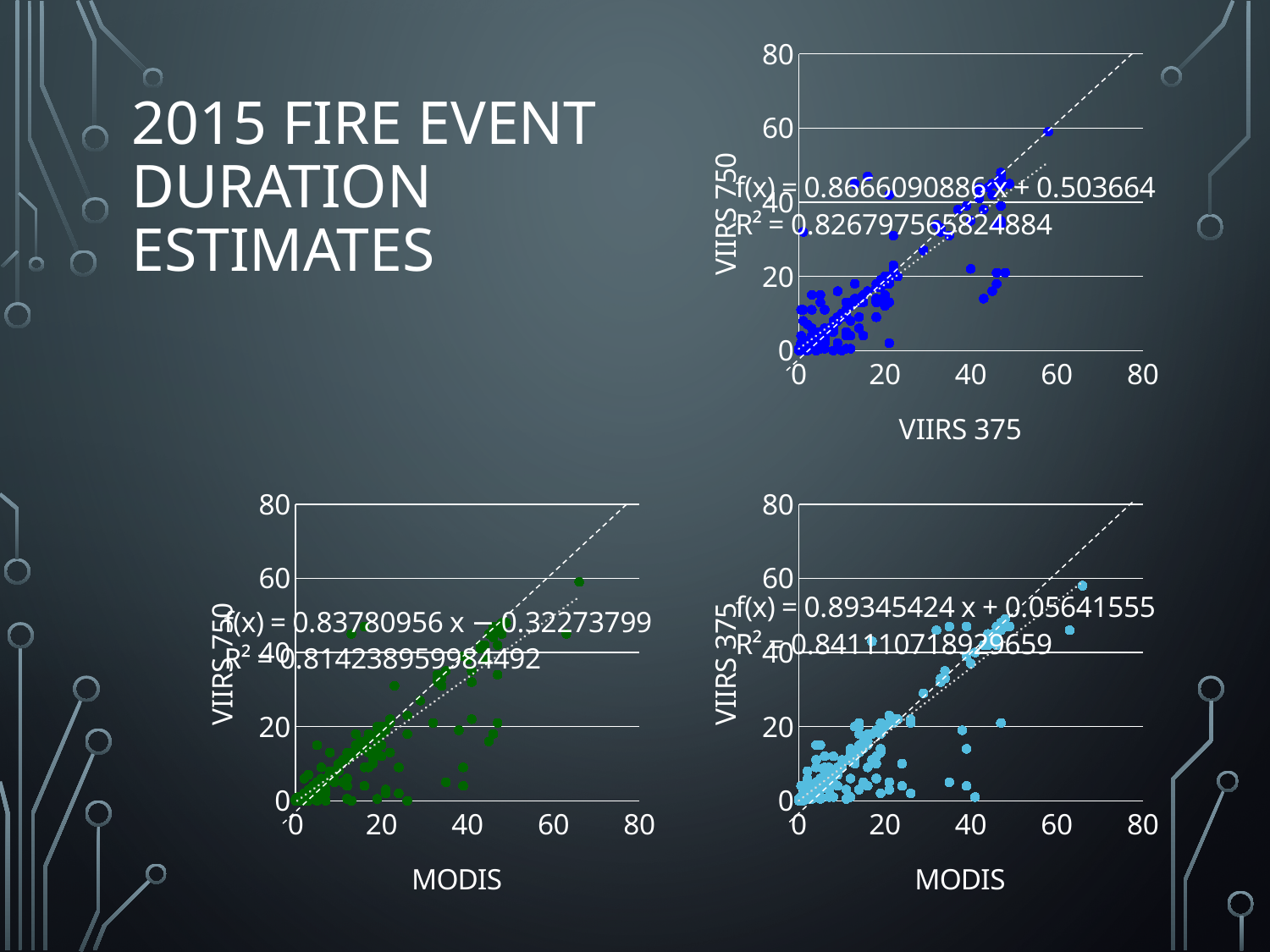
In the bottom-left chart (VIIRS 750 vs MODIS), what is the trendline equation printed on the chart? f(x) = 0.83780956 x − 0.32273799 Which chart has the highest R² value: the top-right, bottom-left, or bottom-right chart? Bottom-right In the bottom-right chart (VIIRS 375 vs MODIS), what is the trendline equation printed on the chart? f(x) = 0.89345424 x + 0.05641555 In the bottom-right chart, what is the label of the y axis? VIIRS 375 What kind of chart is the top-right chart with the x axis labelled VIIRS 375? Scatter chart In the bottom-left chart (VIIRS 750 vs MODIS), do the plotted points generally rise or fall as the x-axis value increases? Rise In the top-right chart, what is the label of the x axis? VIIRS 375 In the top-right chart (VIIRS 750 vs VIIRS 375), what is the R² value printed on the chart? 0.826797565824884 In the bottom-left chart (VIIRS 750 vs MODIS), what is the R² value printed on the chart? 0.814238959984492 How many charts are shown on the slide? 3 In the bottom-right chart (VIIRS 375 vs MODIS), what is the R² value printed on the chart? 0.841110718929659 Which chart has the lowest R² value: the top-right, bottom-left, or bottom-right chart? Bottom-left